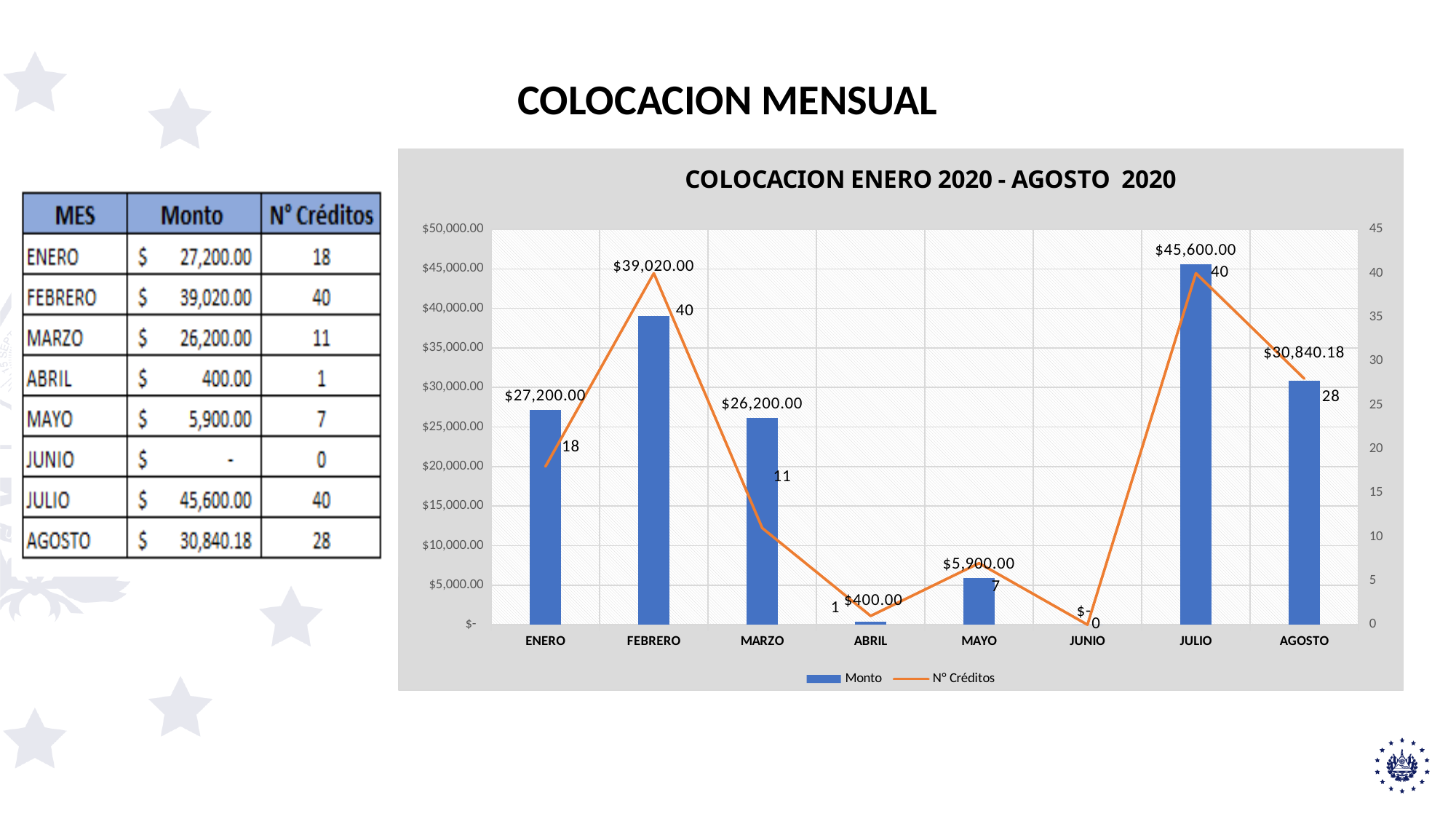
How many series does the chart legend list? 2 What is the difference in Monto between JULIO and FEBRERO? $6,580.00 Which month has a larger Monto, ENERO or MARZO? ENERO Is the Monto for AGOSTO greater or less than $30,000.00? greater What is the N° Créditos value for AGOSTO? 28 What is the Monto value for JULIO? $45,600.00 Which month has the lowest N° Créditos? JUNIO Which month has the highest Monto? JULIO What kind of chart is used to show the Monto series? bar chart Does the N° Créditos line rise or fall from MARZO to ABRIL? fall What is the title of the chart? COLOCACION ENERO 2020 - AGOSTO 2020 How many months are shown on the x axis of the chart? 8